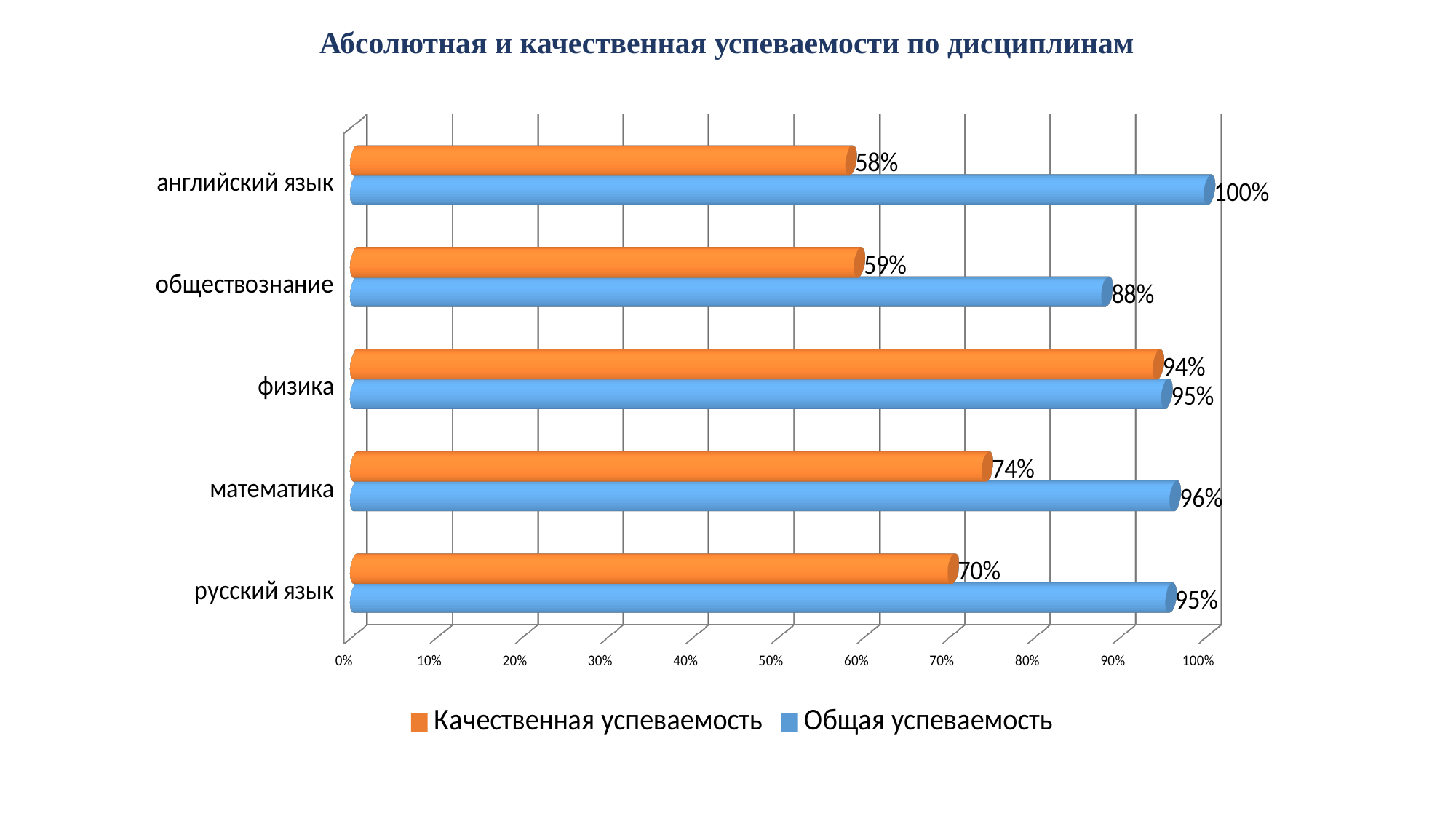
How many series does the legend list? 2 Which discipline has the lowest Общая успеваемость? обществознание What is the Качественная успеваемость value for математика? 74% What is the Качественная успеваемость value for английский язык? 58% What is the title of the chart? Абсолютная и качественная успеваемости по дисциплинам Which is larger: the Качественная успеваемость for математика or for русский язык? математика How many disciplines are shown on the chart? 5 Which discipline has the highest Качественная успеваемость? физика What is the difference between Общая успеваемость and Качественная успеваемость for русский язык? 25% What is the Общая успеваемость value for обществознание? 88% What kind of chart is shown on the slide? bar chart Which discipline has the highest Общая успеваемость? английский язык